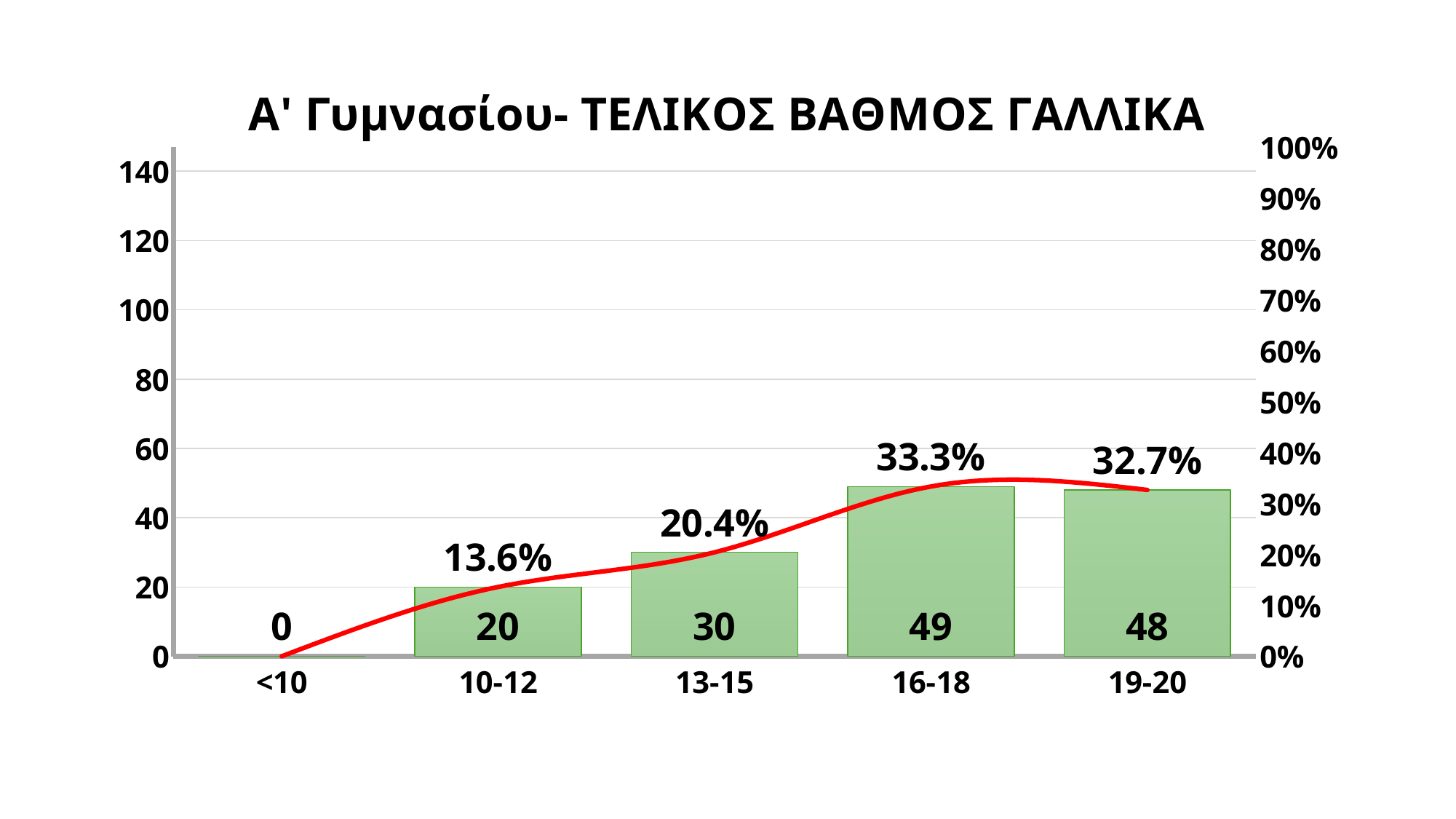
What is the difference between the bar values for 16-18 and 13-15? 19 Which grade band has the highest bar value? 16-18 What percentage is shown for the 19-20 grade band? 32.7% What percentage is shown for the 13-15 grade band? 20.4% What is the number of students in the 16-18 grade band? 49 Is the bar value for 13-15 greater or less than 40? less Which grade band has the lowest bar value? <10 How many grade bands are shown on the x axis? 5 What is the number of students in the 10-12 grade band? 20 What kind of chart is this? Combined bar and line chart Which is larger, the bar value for 19-20 or for 10-12? 19-20 What is the title of the chart? Α' Γυμνασίου- ΤΕΛΙΚΟΣ ΒΑΘΜΟΣ ΓΑΛΛΙΚΑ